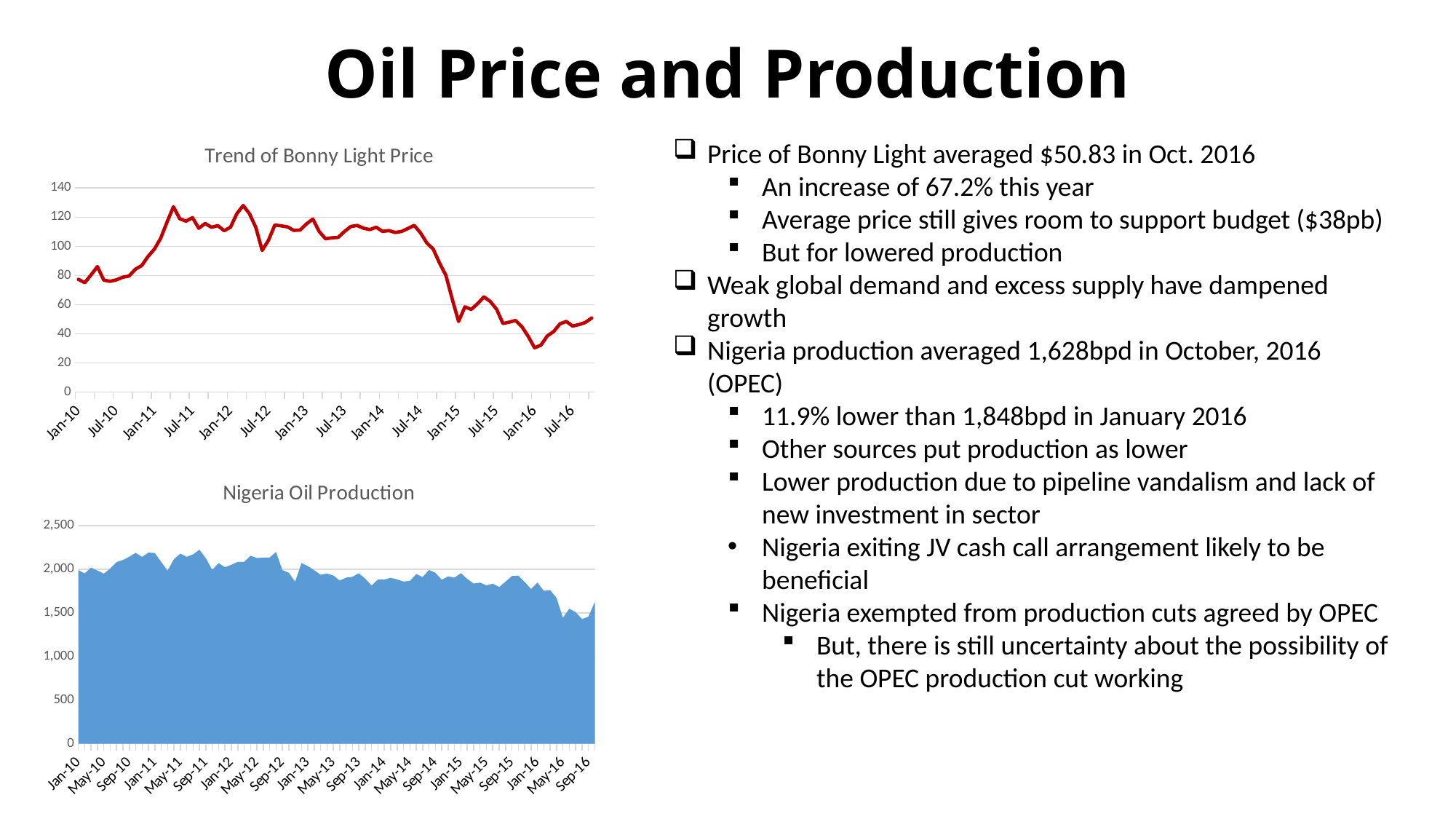
In the 'Nigeria Oil Production' chart, is the value at Jan-10 greater or less than 1,500? greater In the 'Trend of Bonny Light Price' chart, does the price rise or fall between Jul-14 and Jan-16? fall How many charts are shown on the slide? 2 In the 'Trend of Bonny Light Price' chart, in which year does the price reach its lowest point? 2016 In the 'Trend of Bonny Light Price' chart, is the value at Jan-16 greater or less than 40? less In the 'Nigeria Oil Production' chart, is the value at Sep-16 greater or less than 2,000? less What kind of chart is the 'Trend of Bonny Light Price' chart? line chart What kind of chart is the 'Nigeria Oil Production' chart? area chart What colour is the line in the 'Trend of Bonny Light Price' chart? red In the 'Nigeria Oil Production' chart, does production overall rise or fall from Sep-12 to Sep-16? fall